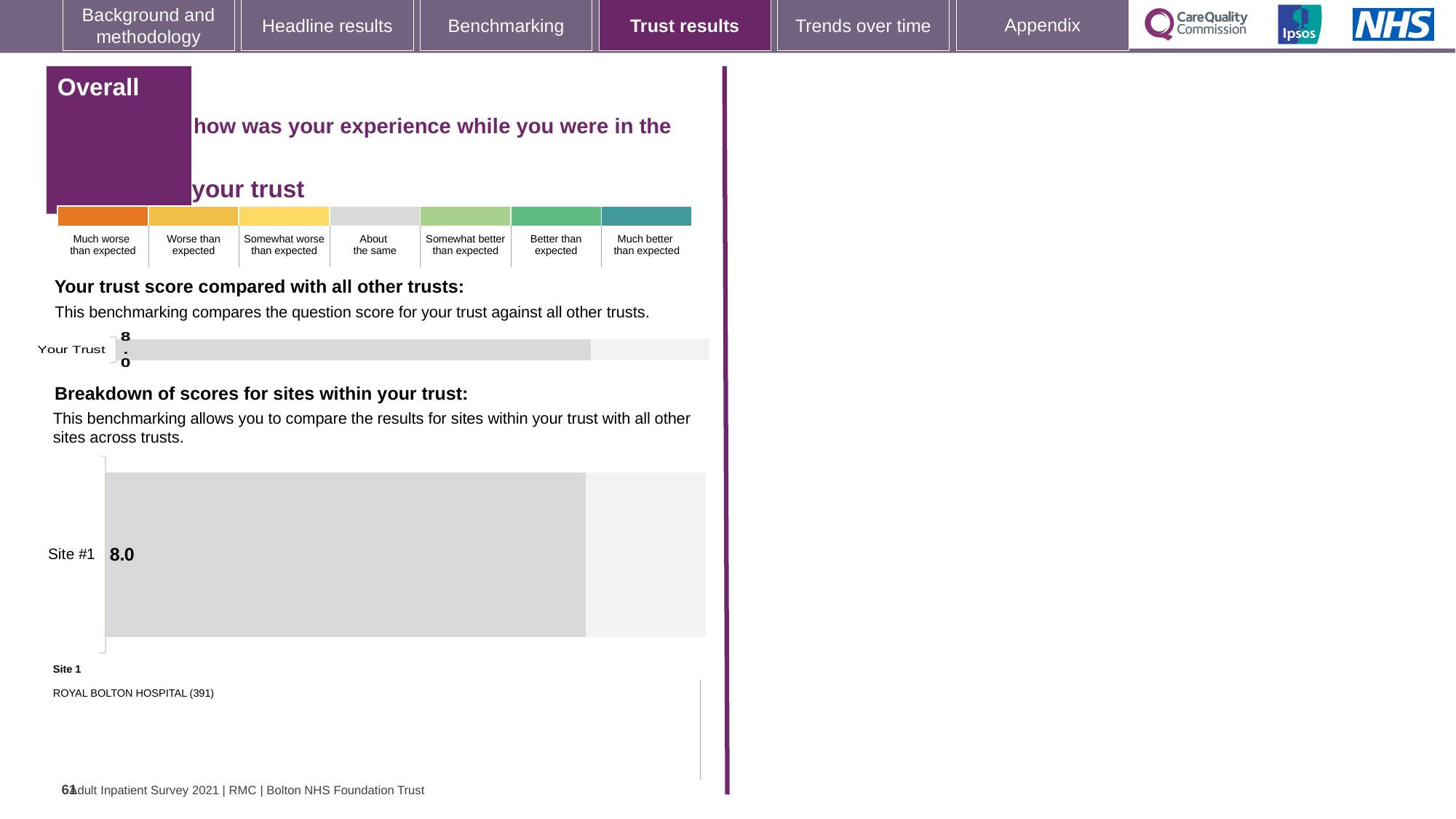
How many categories are plotted in the 'Your trust score compared with all other trusts' chart? 1 Is the value for Site #1 in the 'Breakdown of scores for sites within your trust' chart the same as the value for Your Trust in the 'Your trust score compared with all other trusts' chart? Yes, both are 8.0 What is the category label of the single bar in the 'Breakdown of scores for sites within your trust' chart? Site #1 How many sites are plotted in the 'Breakdown of scores for sites within your trust' chart? 1 In the 'Your trust score compared with all other trusts' chart, what is the value shown for Your Trust? 8.0 What kind of chart is the 'Breakdown of scores for sites within your trust' chart? bar chart In the 'Breakdown of scores for sites within your trust' chart, what is the value for Site #1? 8.0 What is the category label of the single bar in the 'Your trust score compared with all other trusts' chart? Your Trust What kind of chart is the 'Your trust score compared with all other trusts' chart? bar chart